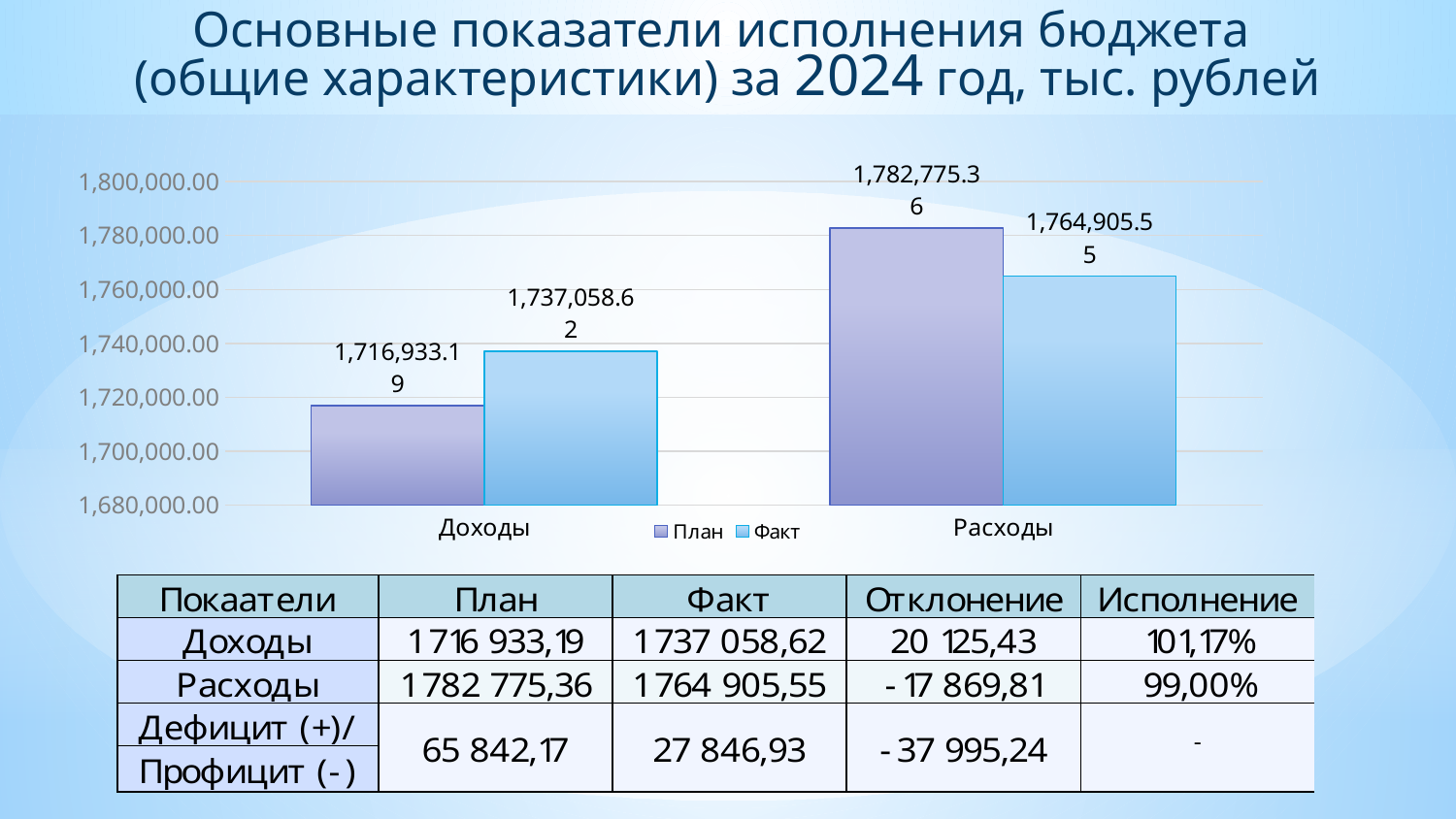
What is the value of the План bar for Доходы? 1,716,933.19 How many series does the chart legend list? 2 What is the value of the Факт bar for Доходы? 1,737,058.62 Is the Факт value for Доходы greater or less than 1,740,000.00? less For Расходы, which is larger: the План value or the Факт value? План Which bar in the chart has the lowest value? План for Доходы What is the value of the Факт bar for Расходы? 1,764,905.55 What is the difference between the Факт and План values for Доходы? 20,125.43 How many categories are shown on the x axis of the chart? 2 What is the value of the План bar for Расходы? 1,782,775.36 Which bar in the chart has the highest value? План for Расходы What type of chart is shown on the slide? bar chart